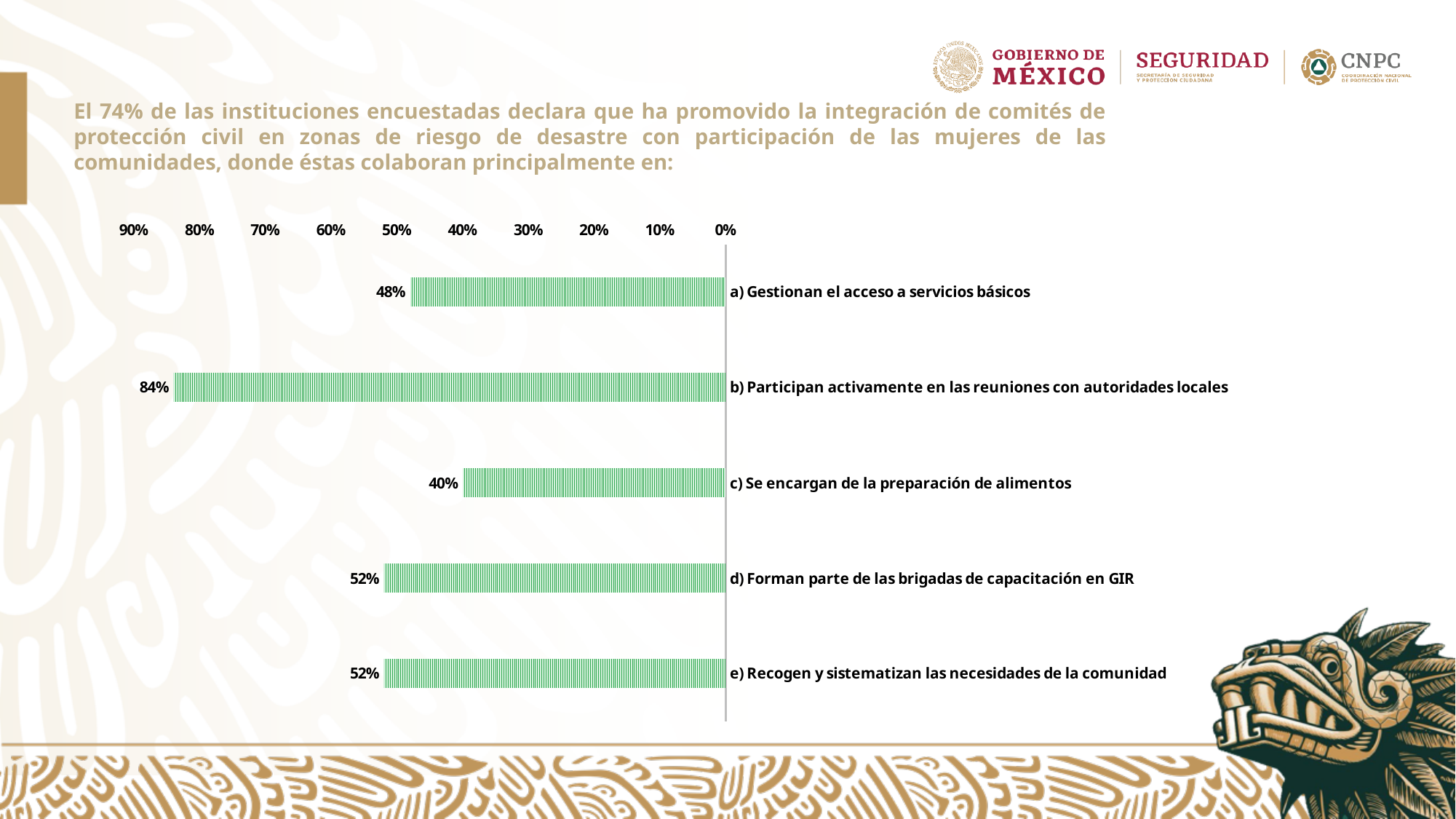
Which is larger: the value for 'd) Forman parte de las brigadas de capacitación en GIR' or 'c) Se encargan de la preparación de alimentos'? d) Forman parte de las brigadas de capacitación en GIR What is the difference between the percentage for 'b) Participan activamente en las reuniones con autoridades locales' and 'a) Gestionan el acceso a servicios básicos'? 36% What percentage is shown for 'a) Gestionan el acceso a servicios básicos'? 48% What percentage is shown for 'd) Forman parte de las brigadas de capacitación en GIR'? 52% Which category has the highest percentage? b) Participan activamente en las reuniones con autoridades locales Which category has the lowest percentage? c) Se encargan de la preparación de alimentos What percentage is shown for 'b) Participan activamente en las reuniones con autoridades locales'? 84% What is the highest value shown on the percentage axis of the chart? 90% Is the value for 'a) Gestionan el acceso a servicios básicos' greater or less than 50%? less What percentage is shown for 'c) Se encargan de la preparación de alimentos'? 40% What kind of chart is shown on the slide? Bar chart How many categories are shown in the chart? 5